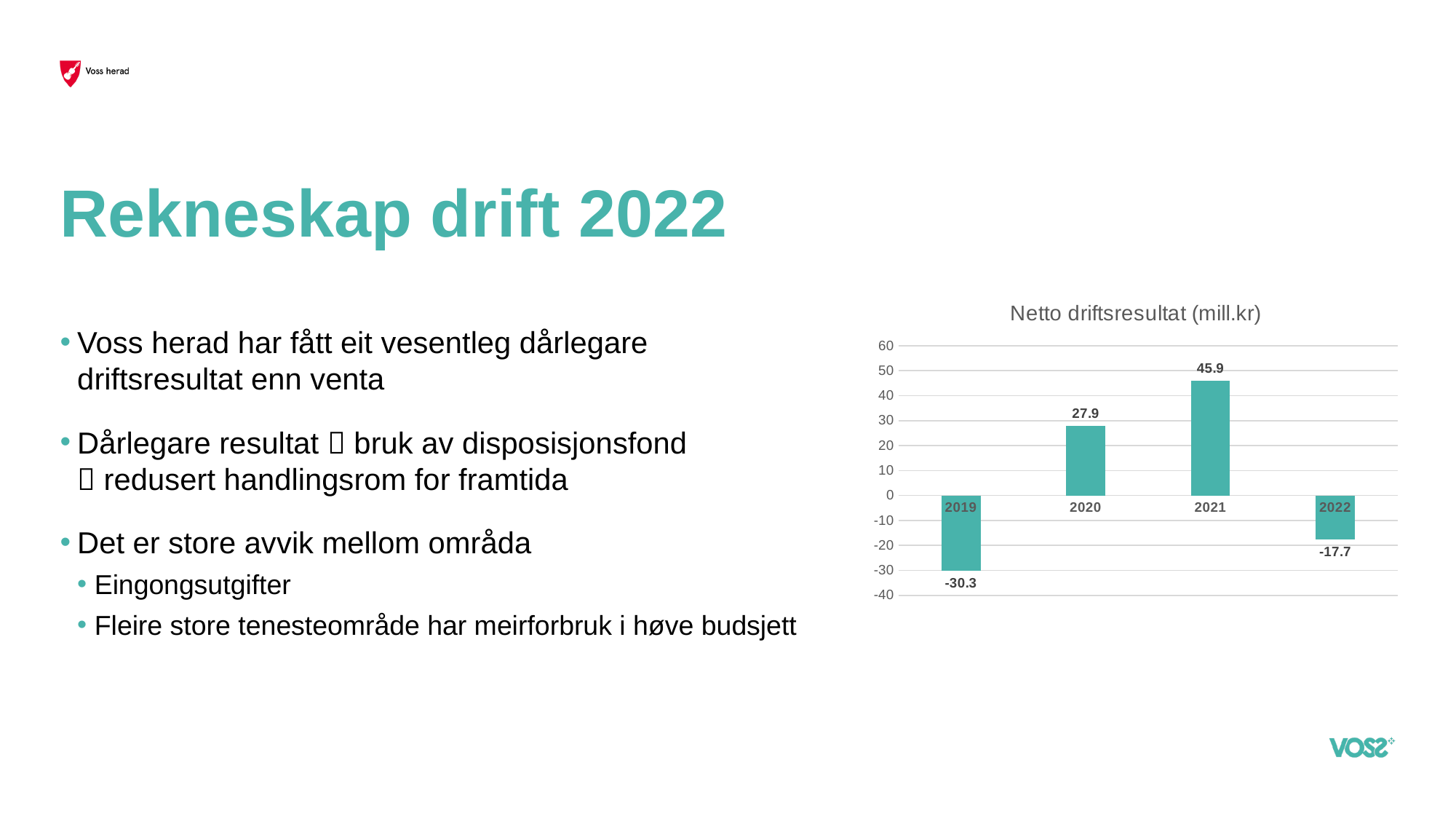
Is the value for 2021 in the Netto driftsresultat chart greater or less than 40? greater What is the value for 2019 in the Netto driftsresultat chart? -30.3 What is the difference between the values for 2021 and 2020 in the Netto driftsresultat chart? 18.0 How many years are shown in the Netto driftsresultat chart? 4 Which is larger in the Netto driftsresultat chart, the value for 2020 or the value for 2022? 2020 Which year has the highest value in the Netto driftsresultat chart? 2021 What is the value for 2020 in the Netto driftsresultat chart? 27.9 Which year has the lowest value in the Netto driftsresultat chart? 2019 What kind of chart is the Netto driftsresultat chart? bar chart What is the value for 2021 in the Netto driftsresultat chart? 45.9 What is the value for 2022 in the Netto driftsresultat chart? -17.7 What is the title of the chart on the slide? Netto driftsresultat (mill.kr)